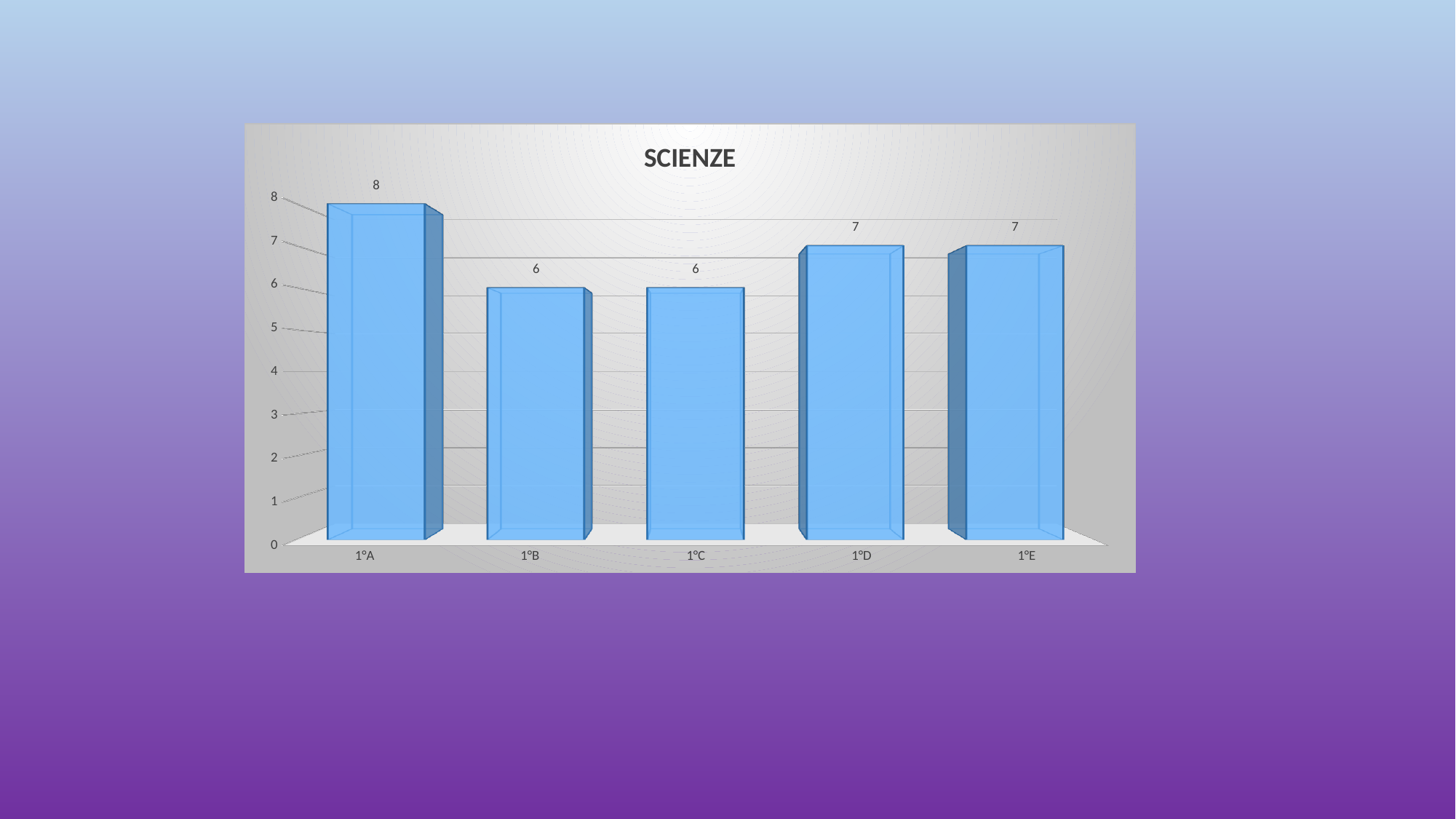
What is the difference between the values for 1°D and 1°B? 1 Which category has the highest value? 1°A What is the value for 1°E? 7 What is the value for 1°D? 7 What is the title of the chart? SCIENZE Which is larger, the value for 1°A or the value for 1°E? 1°A What is the value for 1°B? 6 Is the value for 1°C greater or less than 7? less What is the difference between the values for 1°A and 1°C? 2 What kind of chart is shown on the slide? bar chart How many categories are shown on the x axis? 5 What is the value for 1°A? 8